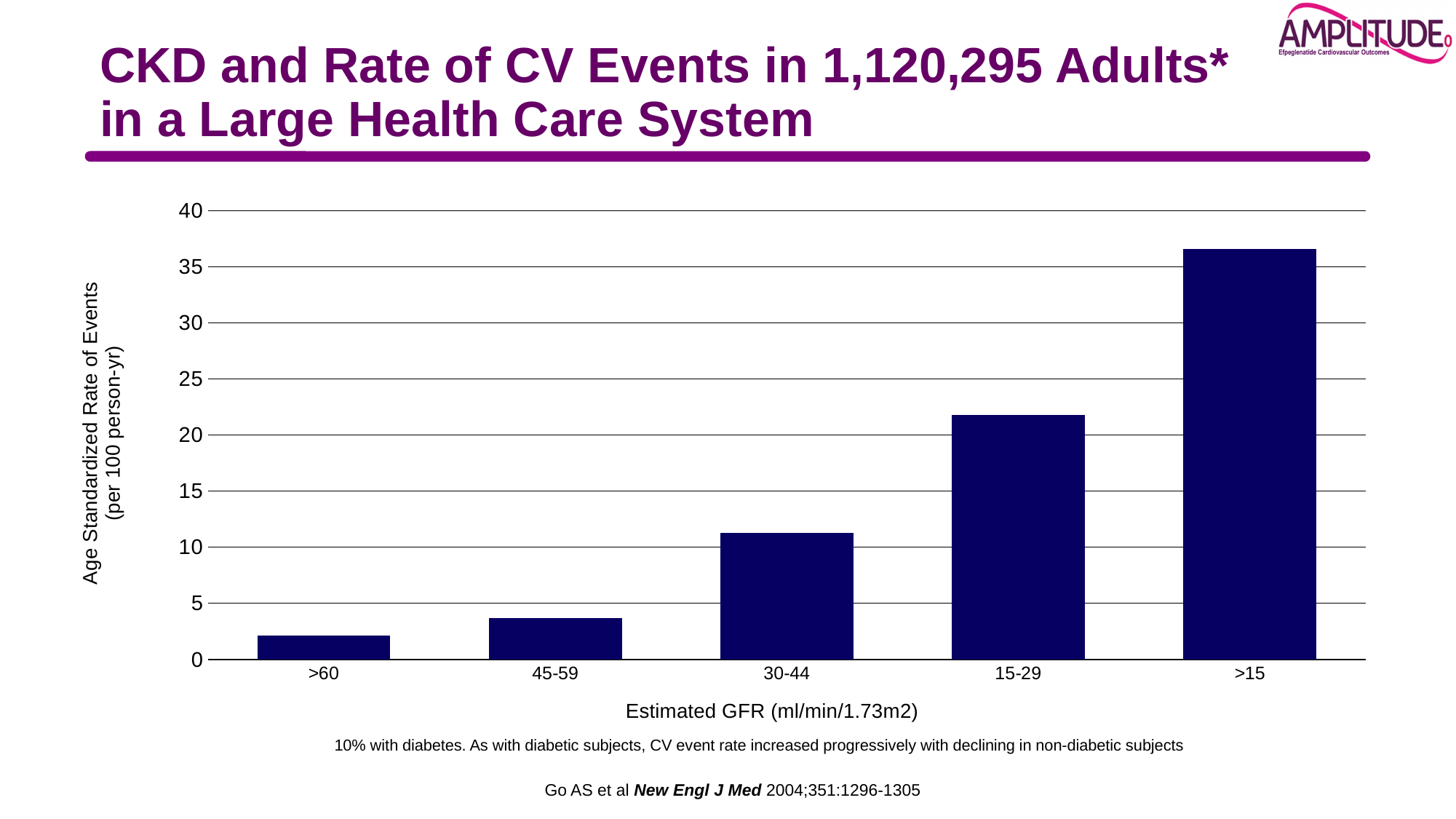
Do the values rise or fall moving from left to right along the x axis? rise Is the value for the 45-59 category greater or less than 5? less How many estimated GFR categories are plotted on the x axis? 5 What is the label of the x axis? Estimated GFR (ml/min/1.73m2) Which has a higher rate of events, the 30-44 category or the 15-29 category? 15-29 What type of chart is shown on the slide? bar chart Is the value for the >15 category greater or less than 35? greater Which estimated GFR category has the lowest age standardized rate of events? >60 Is the value for the 30-44 category greater or less than 10? greater Which estimated GFR category has the highest age standardized rate of events? >15